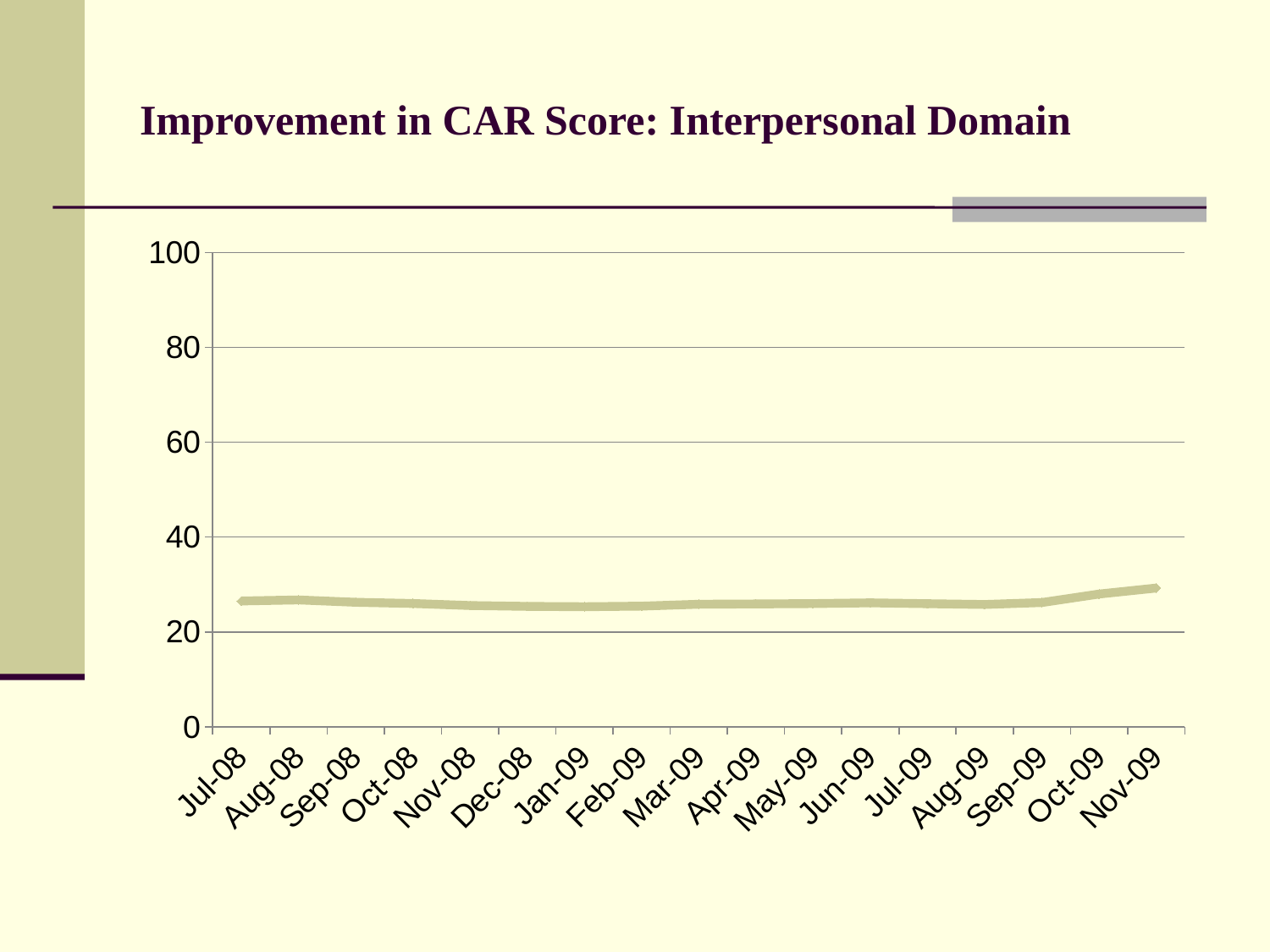
Is the value for Jan-09 greater or less than 20? greater What kind of chart is shown on the slide? line chart What is the highest tick value shown on the y axis? 100 Which month has the highest value on the line? Nov-09 Does the line rise or fall between Aug-09 and Nov-09? rise How many months are plotted along the x axis? 17 Is the value for Jul-08 greater or less than 20? greater Is the value for Jul-08 greater or less than 40? less What is the title of the chart on the slide? Improvement in CAR Score: Interpersonal Domain Which is larger, the value for Jul-08 or the value for Nov-09? Nov-09 Which month is the first on the x axis? Jul-08